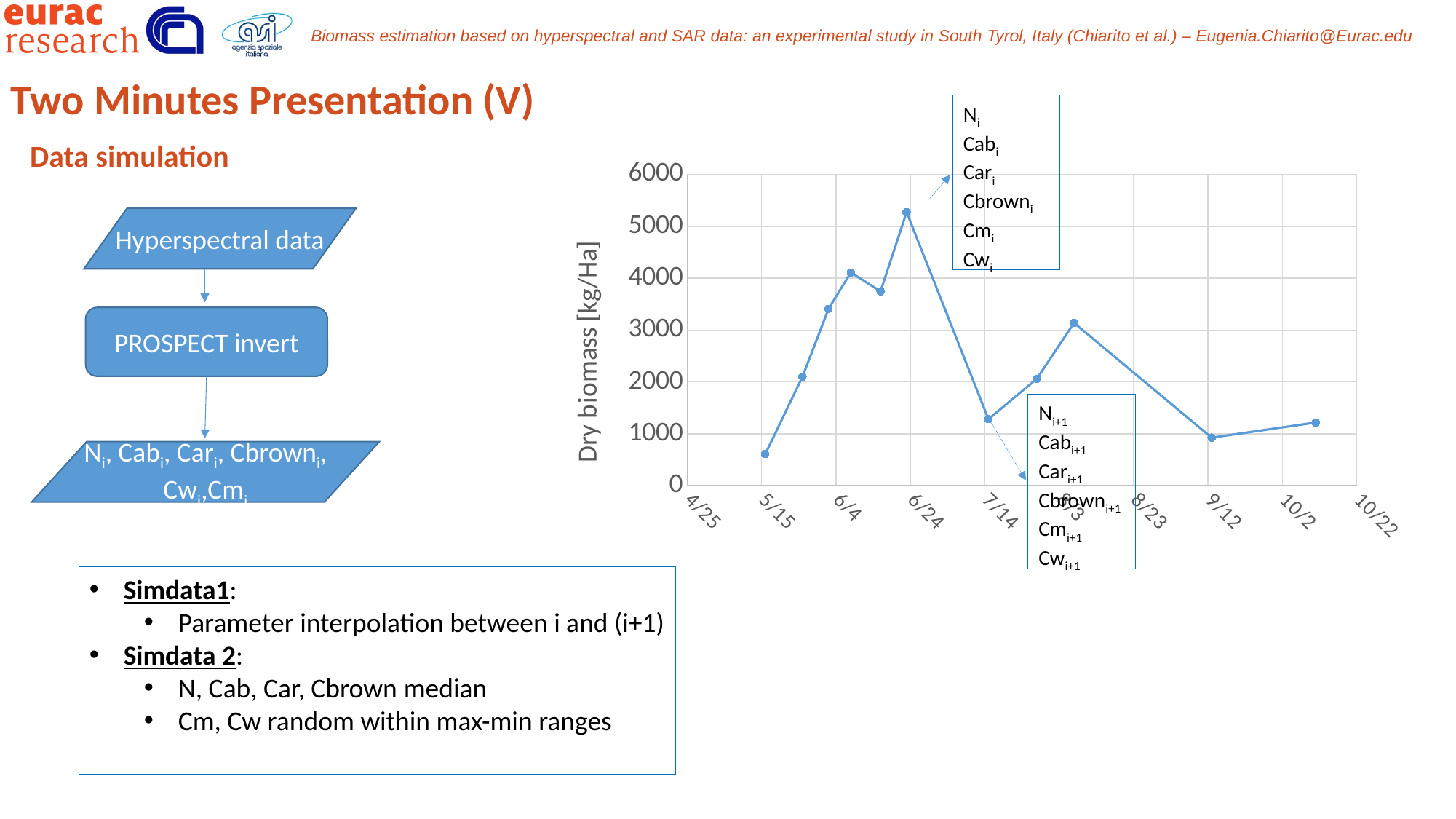
Is the dry biomass value at 7/14 greater or less than 2000? less Around which x-axis date does the dry biomass reach its highest value? 6/24 What is the label of the vertical axis of the chart? Dry biomass [kg/Ha] How many data points are plotted on the line in the chart? 11 Is the peak dry biomass value near 6/24 greater or less than 5000? greater Around which x-axis date does the dry biomass have its lowest value? 5/15 Is the first plotted dry biomass value near 5/15 greater or less than 1000? less What is the highest value shown on the vertical axis of the chart? 6000 Which is larger: the dry biomass peak near 6/24 or the peak near 8/3? the peak near 6/24 Does the dry biomass rise or fall between 6/24 and 7/14? fall What kind of chart is shown on the slide? line chart Does the dry biomass rise or fall between 5/15 and 6/24? rise